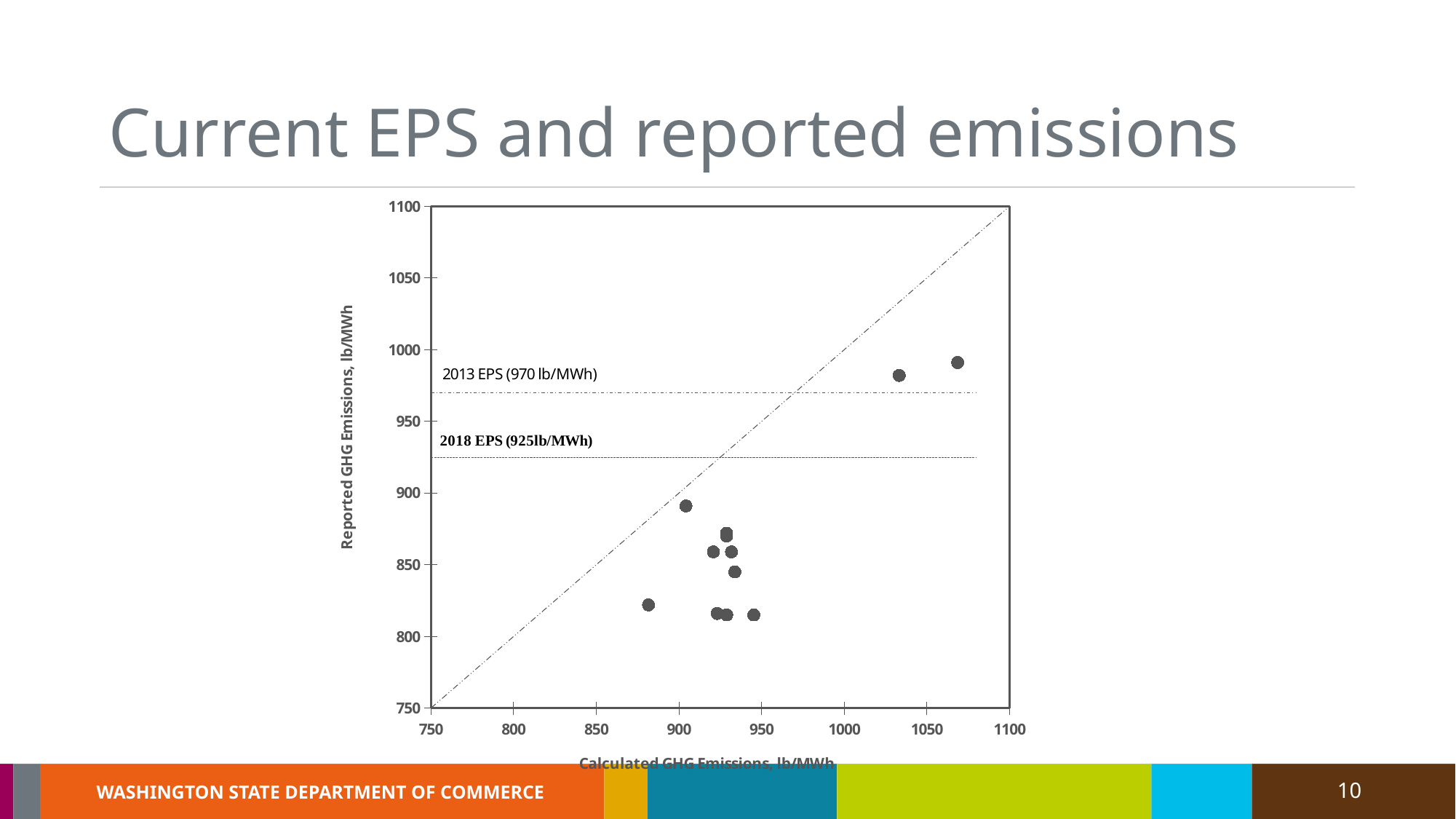
Are the reported emissions of the points in the lower cluster greater or less than 900 lb/MWh? less What is the 2018 EPS value marked by the horizontal reference line? 925 lb/MWh What is the label of the x axis? Calculated GHG Emissions, lb/MWh Which EPS reference line is higher, the 2013 EPS or the 2018 EPS? 2013 EPS Is the calculated emissions value of the leftmost point greater or less than 900 lb/MWh? less What is the maximum value shown on the y axis? 1100 Is the calculated emissions value of the rightmost point greater or less than 1050 lb/MWh? greater What kind of chart is shown on the slide? scatter plot What is the difference between the 2013 EPS and the 2018 EPS reference values? 45 lb/MWh What is the label of the y axis? Reported GHG Emissions, lb/MWh What is the 2013 EPS value marked by the horizontal reference line? 970 lb/MWh